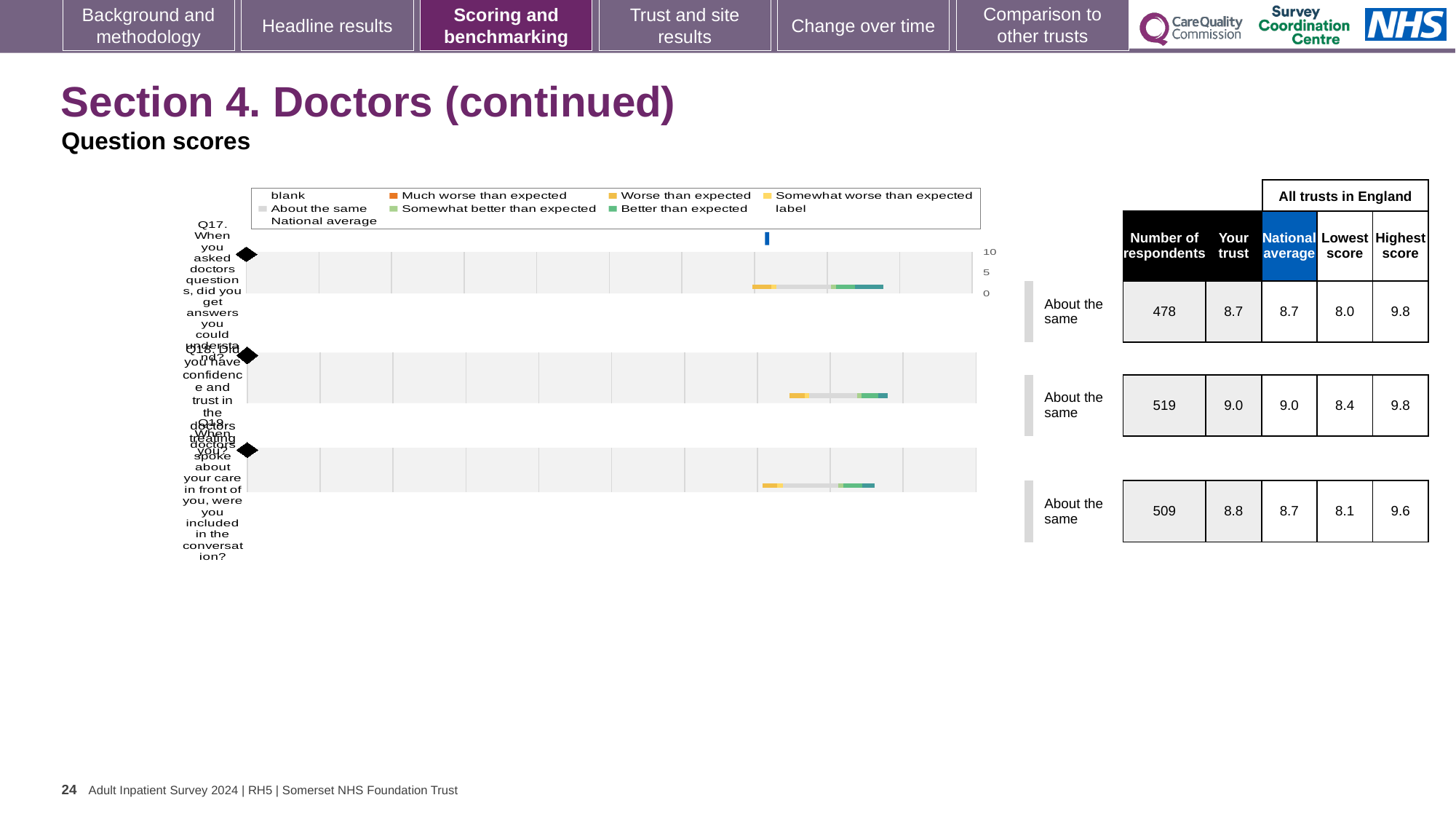
What is the highest score among all trusts in England for Q19? 9.6 What is the difference between the 'Your trust' score and the national average for Q19? 0.1 Which question has the lowest 'Your trust' score? Q17 How many respondents answered Q18? 519 What kind of chart is shown on the slide? bar chart What is the national average score for Q19 (When doctors spoke about your care in front of you, were you included in the conversation?)? 8.7 How many questions (categories) are plotted in the chart? 3 Which is larger: the 'Your trust' score for Q18 or for Q17? Q18 What is the 'Your trust' score for Q18 (Did you have confidence and trust in the doctors treating you?)? 9.0 What is the 'Your trust' score for Q17 (When you asked doctors questions, did you get answers you could understand?)? 8.7 Which question has the highest 'Your trust' score? Q18 What benchmark category is shown for Q17? About the same